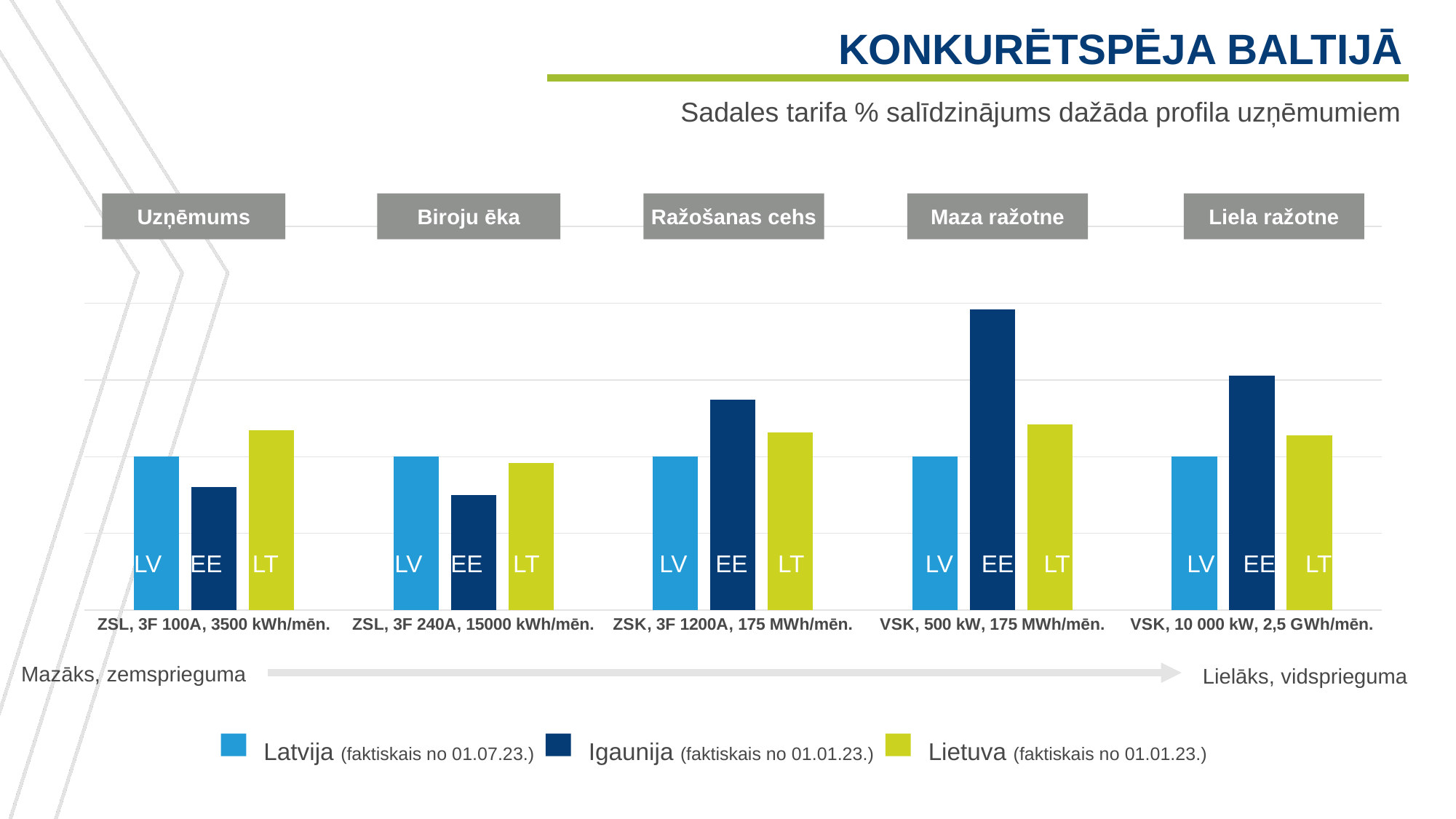
Which country has the highest bar in the Uzņēmums group? LT (Lietuva) How many company profile groups are shown on the chart? 5 How many series does the legend list? 3 In the Biroju ēka group, is the LV bar or the EE bar taller? LV Which profile group contains the tallest bar on the whole chart? Maza ražotne What kind of chart is shown on the slide? Bar chart In the Ražošanas cehs group, is the EE bar or the LT bar taller? EE Which country has the lowest bar in the Uzņēmums group? EE (Igaunija) Which country has the highest bar in the Liela ražotne group? EE (Igaunija) Which country has the lowest bar in the Biroju ēka group? EE (Igaunija) What is the title of the slide? KONKURĒTSPĒJA BALTIJĀ